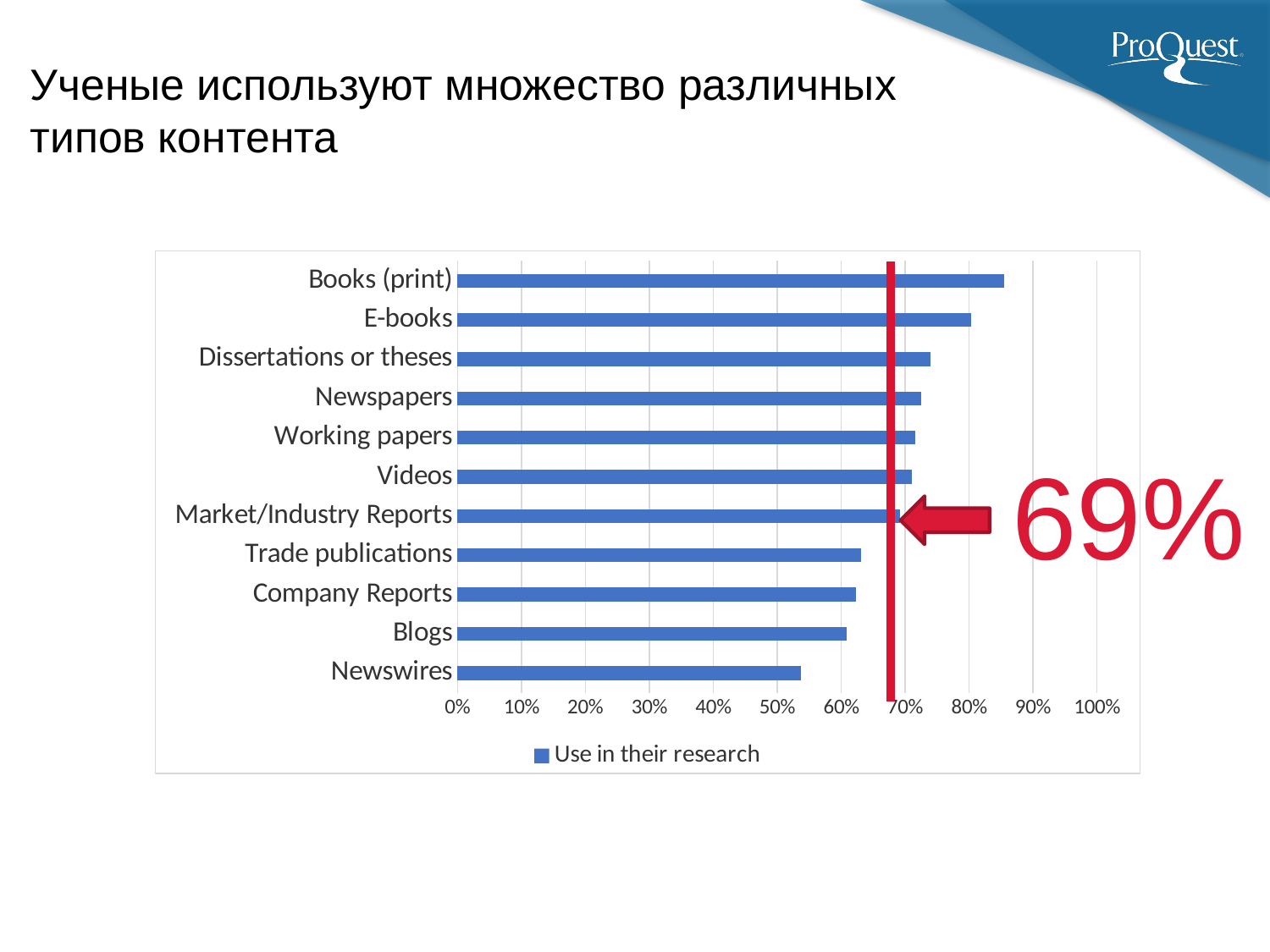
What kind of chart is shown on the slide? bar chart What value is annotated for Market/Industry Reports? 69% Is the value for Newswires greater or less than 60%? less Which content type has the lowest value in the chart? Newswires Is the value for Books (print) greater or less than 80%? greater Which content type has the highest value in the chart? Books (print) Which has a larger value, Dissertations or theses or Blogs? Dissertations or theses Is the value for Company Reports greater or less than 70%? less What is the name of the series shown in the chart legend? Use in their research How many content types (categories) are plotted in the chart? 11 How many series does the chart legend list? 1